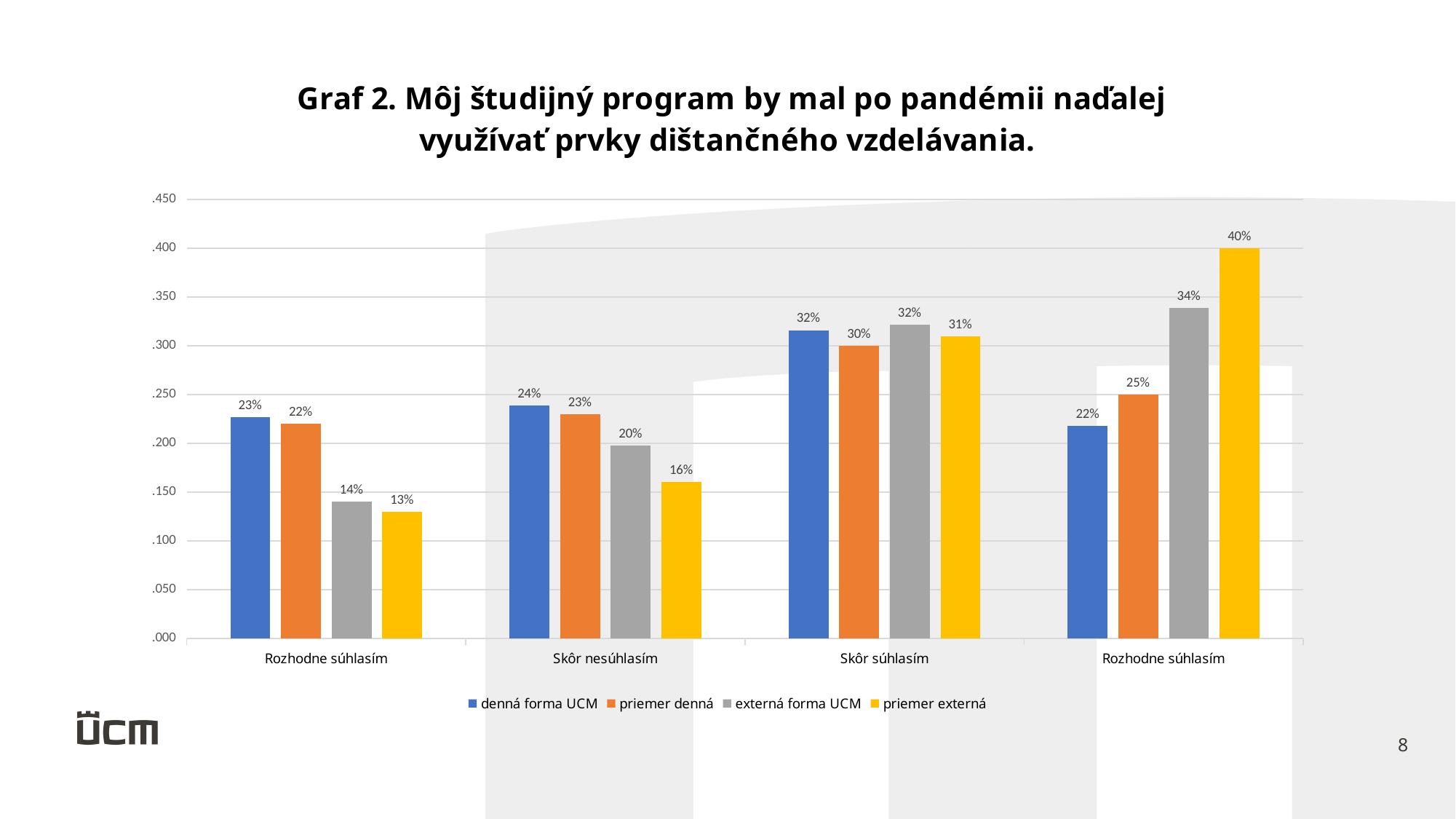
What is the lowest value shown in the chart? 13% Which series has the tallest bar in the whole chart? priemer externá For Skôr nesúhlasím, which is larger: denná forma UCM or priemer externá? denná forma UCM What kind of chart is shown on the slide? bar chart Does the priemer externá series rise or fall from the leftmost category to the rightmost category? rise What is the value of the priemer denná bar in the leftmost category group? 22% How many category groups are shown on the x axis? 4 How many series does the legend list? 4 What is the value of the priemer externá bar in the rightmost category group? 40% In the rightmost category group, what is the difference between the priemer externá bar and the denná forma UCM bar? 18 percentage points What is the value of the externá forma UCM bar for Skôr súhlasím? 32% What is the value of the denná forma UCM bar for Skôr nesúhlasím? 24%